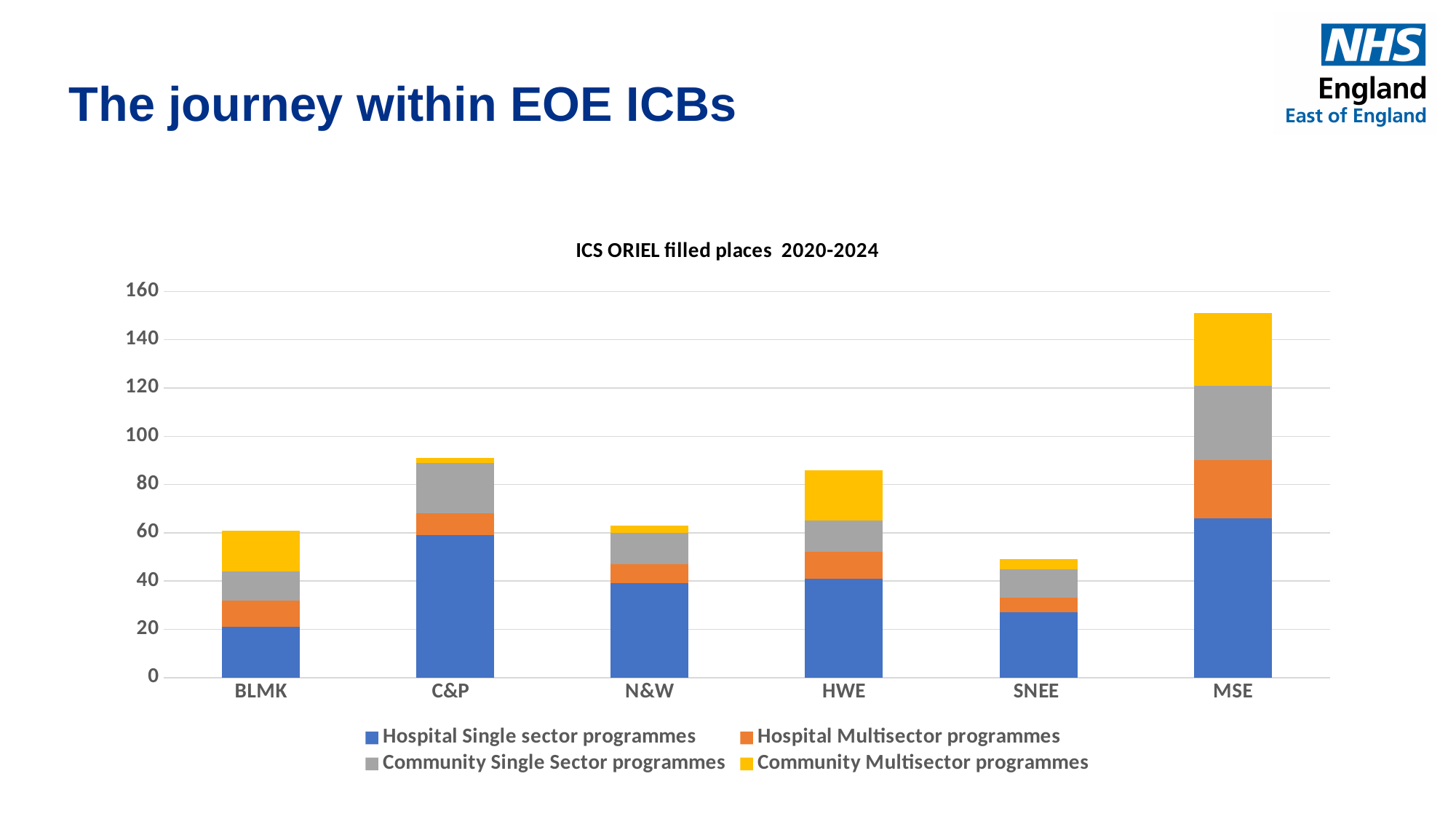
How many ICB categories are shown on the x axis? 6 Which series is shown in yellow in the legend? Community Multisector programmes What type of chart is shown on the slide? Stacked bar chart What is the title of the chart? ICS ORIEL filled places 2020-2024 How many series does the legend list? 4 Which ICB has the highest total of filled places? MSE Is the total for C&P greater or less than 80? greater Is the total for SNEE greater or less than 60? less Which has a larger total of filled places, C&P or N&W? C&P Which ICB has the lowest total of filled places? SNEE Is the total for MSE greater or less than 140? greater